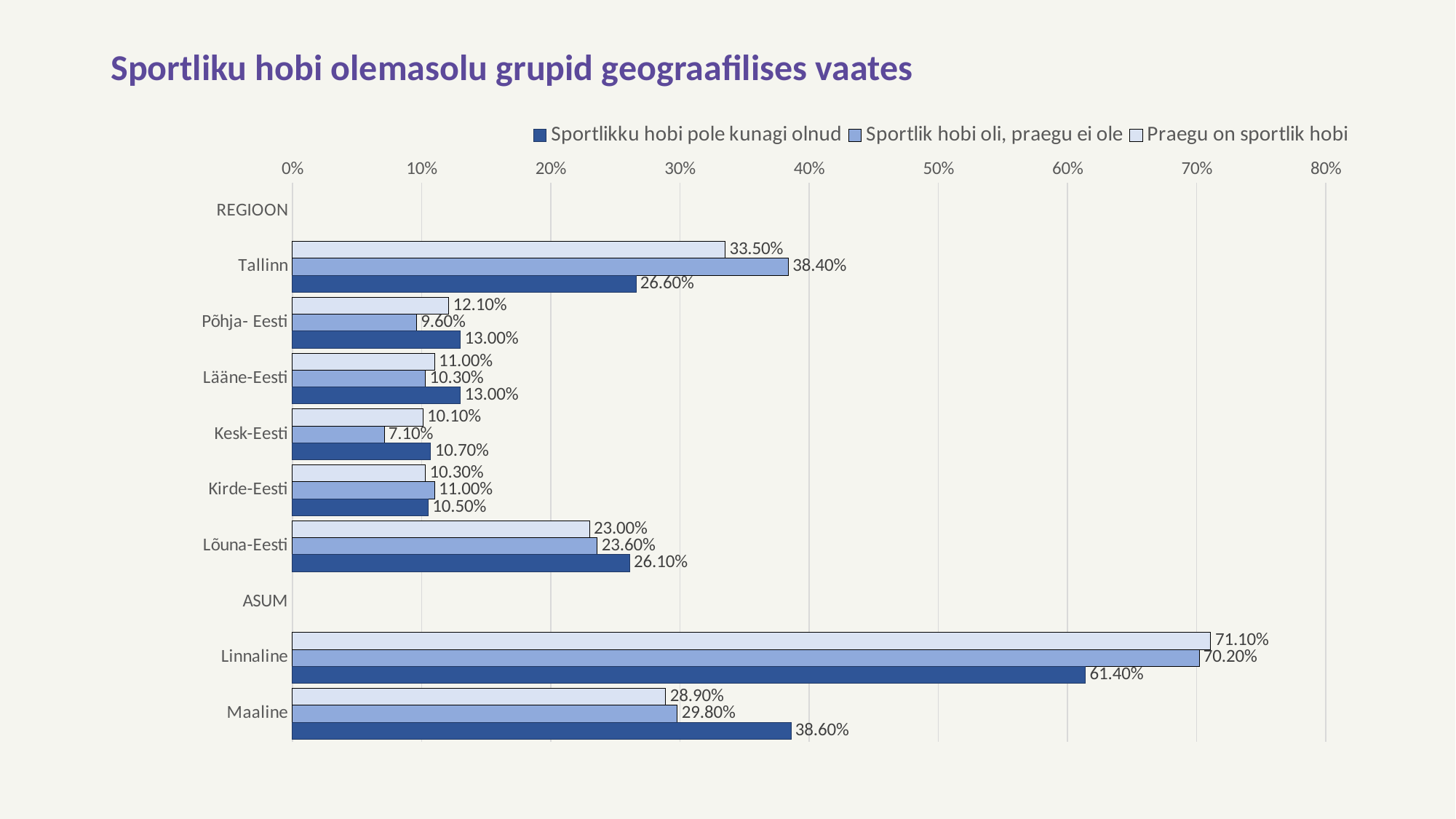
Among the regions under REGIOON, which has the lowest value in the "Sportlik hobi oli, praegu ei ole" series? Kesk-Eesti What is the value for Kesk-Eesti in the "Sportlik hobi oli, praegu ei ole" series? 7.10% Which is larger for Tallinn: the "Praegu on sportlik hobi" value or the "Sportlikku hobi pole kunagi olnud" value? Praegu on sportlik hobi What is the value for Tallinn in the "Sportlik hobi oli, praegu ei ole" series? 38.40% What is the value for Linnaline in the "Praegu on sportlik hobi" series? 71.10% What kind of chart is shown on the slide? Bar chart What is the difference between the "Sportlikku hobi pole kunagi olnud" values for Tallinn and Lõuna-Eesti? 0.50% What is the difference between the "Praegu on sportlik hobi" values for Linnaline and Maaline? 42.20% How many series does the legend list? 3 What is the value for Maaline in the "Sportlikku hobi pole kunagi olnud" series? 38.60% Among the regions under REGIOON, which has the highest value in the "Praegu on sportlik hobi" series? Tallinn Is the value for Linnaline in the "Sportlikku hobi pole kunagi olnud" series greater or less than 60%? greater